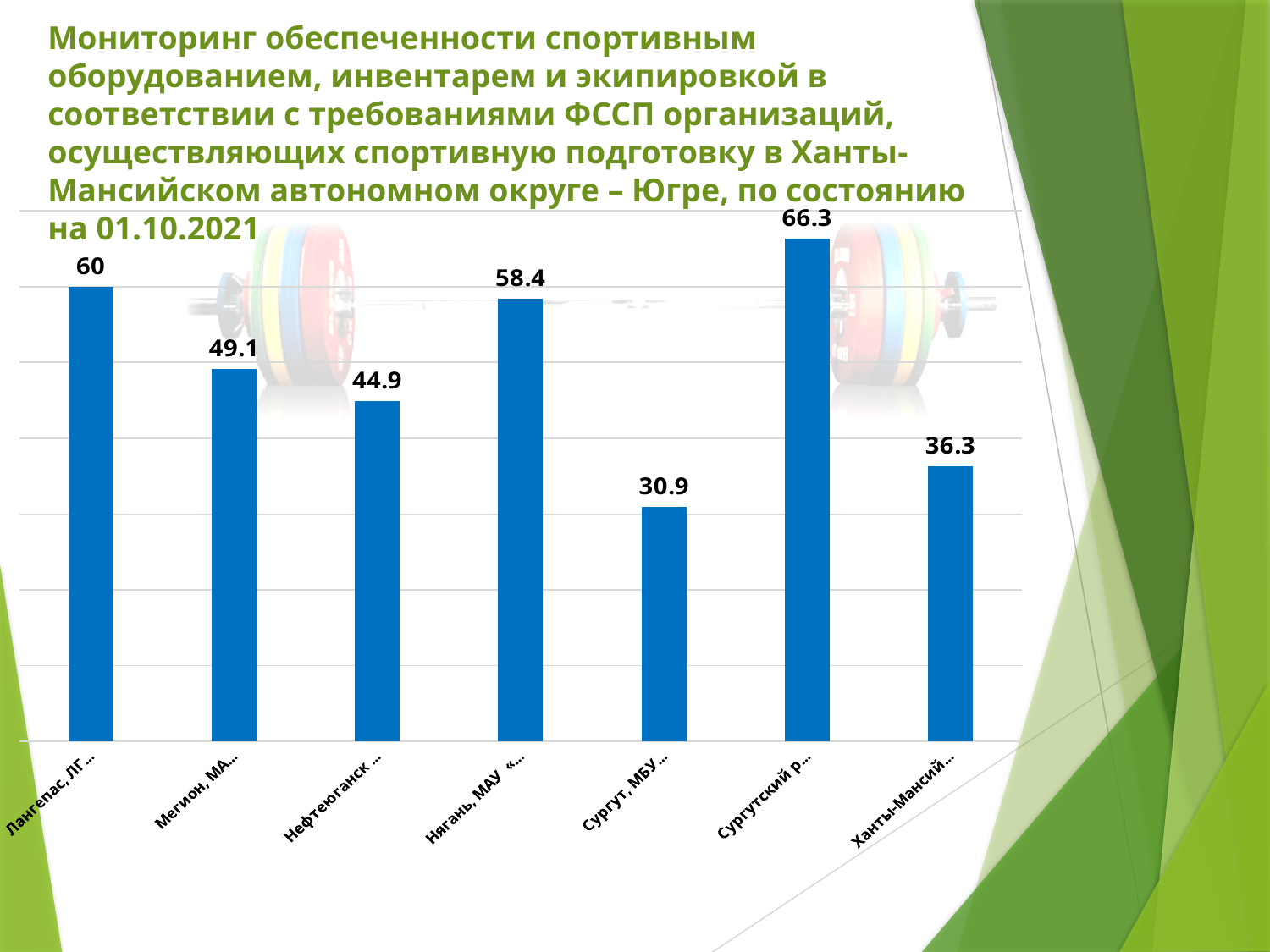
What is the difference between the values for Сургутский р... and Сургут, МБУ ...? 35.4 Which category has the lowest value? Сургут, МБУ ... What colour are the bars in the chart? blue Which is larger, the value for Лангепас or the value for Нягань? Лангепас Which category has the highest value? Сургутский р... What is the value for the bar labelled Нефтеюганск? 44.9 How many bars (categories) are plotted in the chart? 7 What is the value for the bar labelled Лангепас? 60 What is the value for the bar labelled Нягань? 58.4 What is the value for the bar labelled Сургут, МБУ? 30.9 What type of chart is shown on the slide? bar chart What is the value for the bar labelled Мегион? 49.1